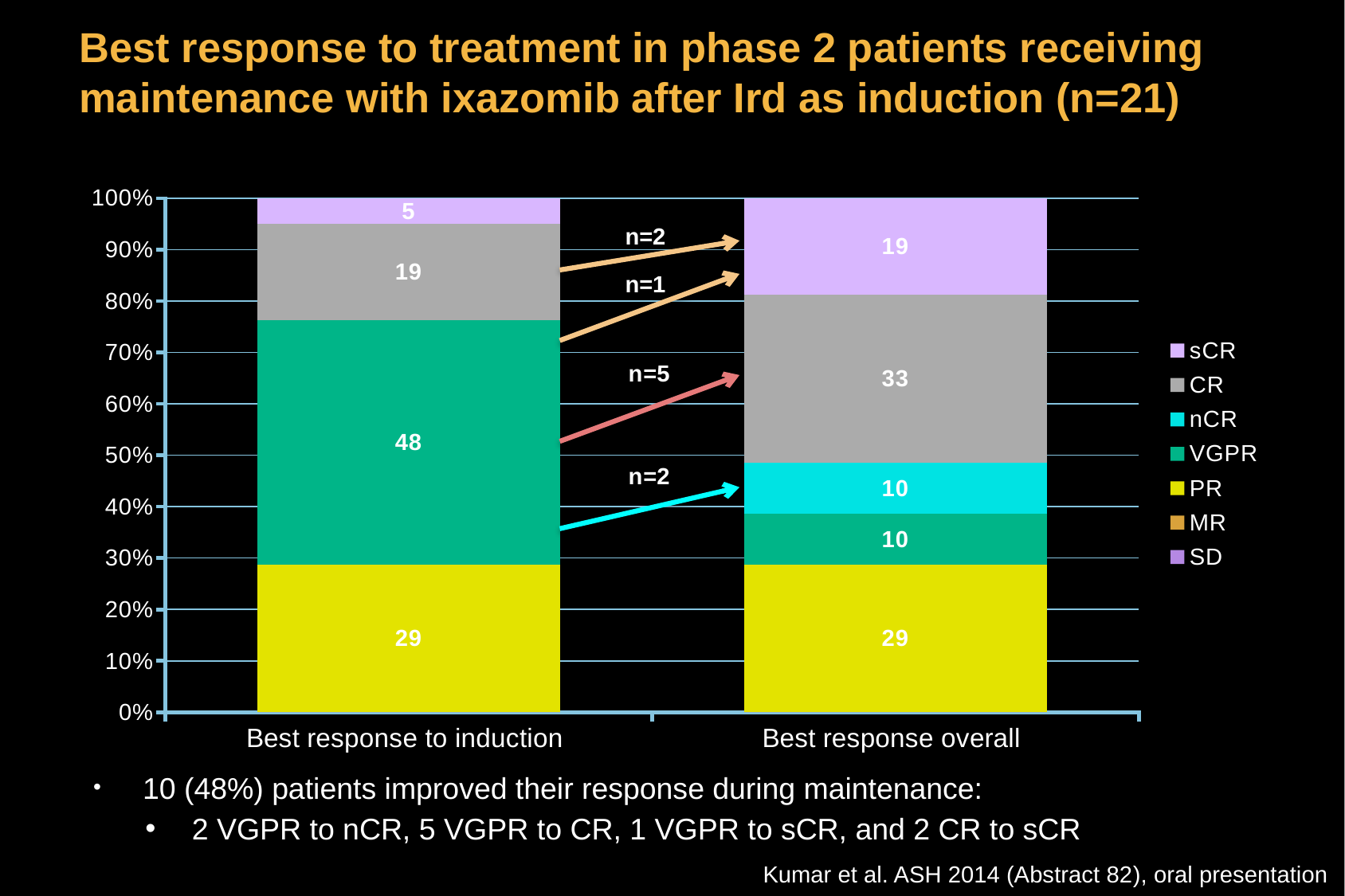
How many series does the legend list? 7 Which segment is the largest in the Best response to induction bar? VGPR Which is larger: the VGPR value for Best response to induction or the VGPR value for Best response overall? Best response to induction What is the CR value for Best response overall? 33 What is the nCR value for Best response overall? 10 What kind of chart is shown on the slide? Stacked bar chart What is the sCR value for Best response to induction? 5 What is the VGPR value for Best response to induction? 48 How many categories are shown on the x axis? 2 Which legend entry is shown in grey? CR What is the difference between the sCR value for Best response overall and the sCR value for Best response to induction? 14 Which segment is the smallest in the Best response to induction bar? sCR